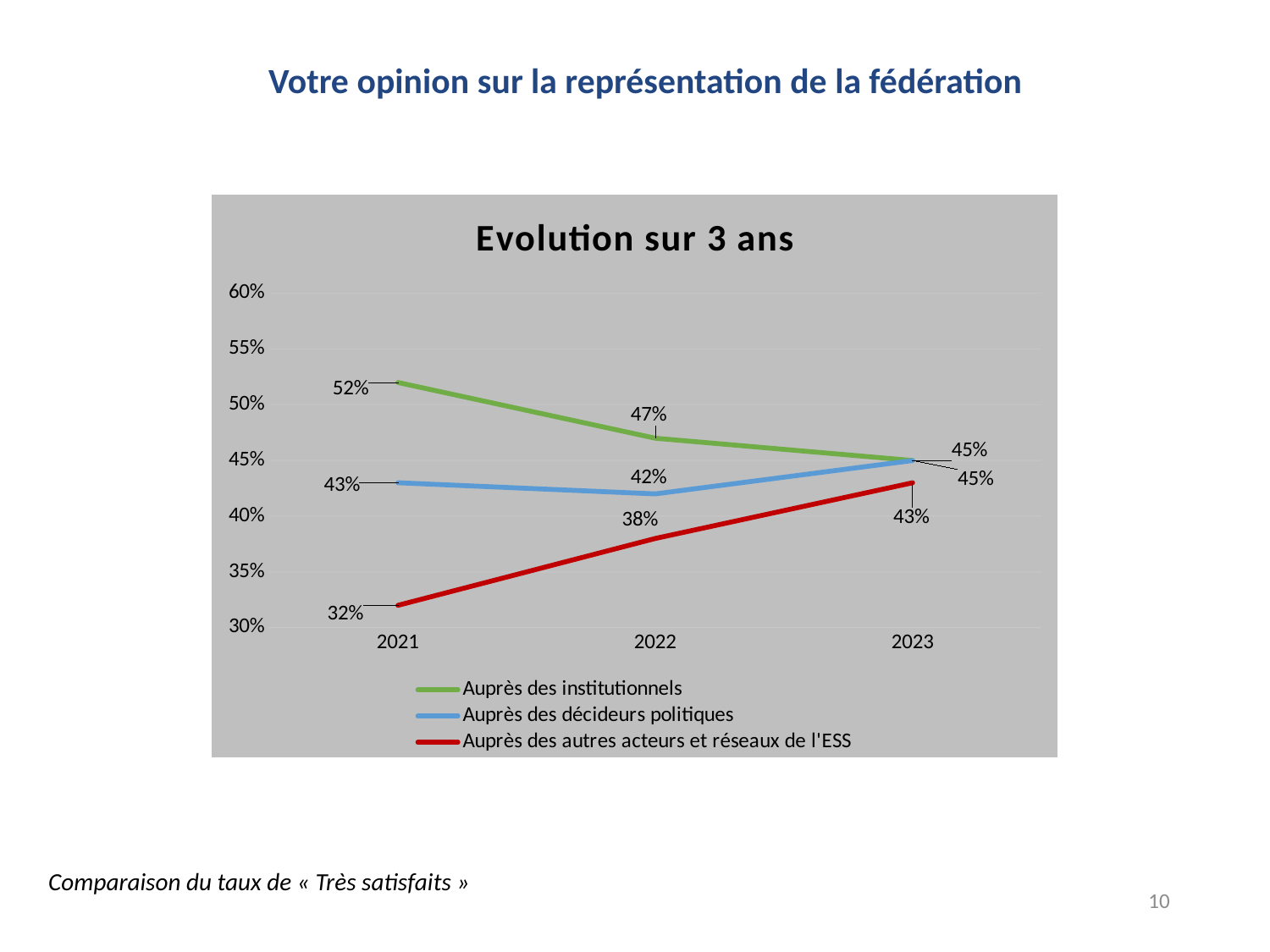
Does the 'Auprès des institutionnels' series rise or fall from 2021 to 2023? Fall In 2022, which is larger: the value for 'Auprès des décideurs politiques' or for 'Auprès des autres acteurs et réseaux de l'ESS'? Auprès des décideurs politiques Which series has the highest value in 2022? Auprès des institutionnels What is the difference between the 2021 and 2023 values for 'Auprès des autres acteurs et réseaux de l'ESS'? 11% What is the value for 'Auprès des autres acteurs et réseaux de l'ESS' in 2022? 38% What type of chart is shown on the slide? Line chart What is the value for 'Auprès des institutionnels' in 2021? 52% How many years are shown on the x axis? 3 What is the value for 'Auprès des décideurs politiques' in 2023? 45% Which series has the lowest value in 2021? Auprès des autres acteurs et réseaux de l'ESS How many series does the legend list? 3 What is the title of the chart? Evolution sur 3 ans